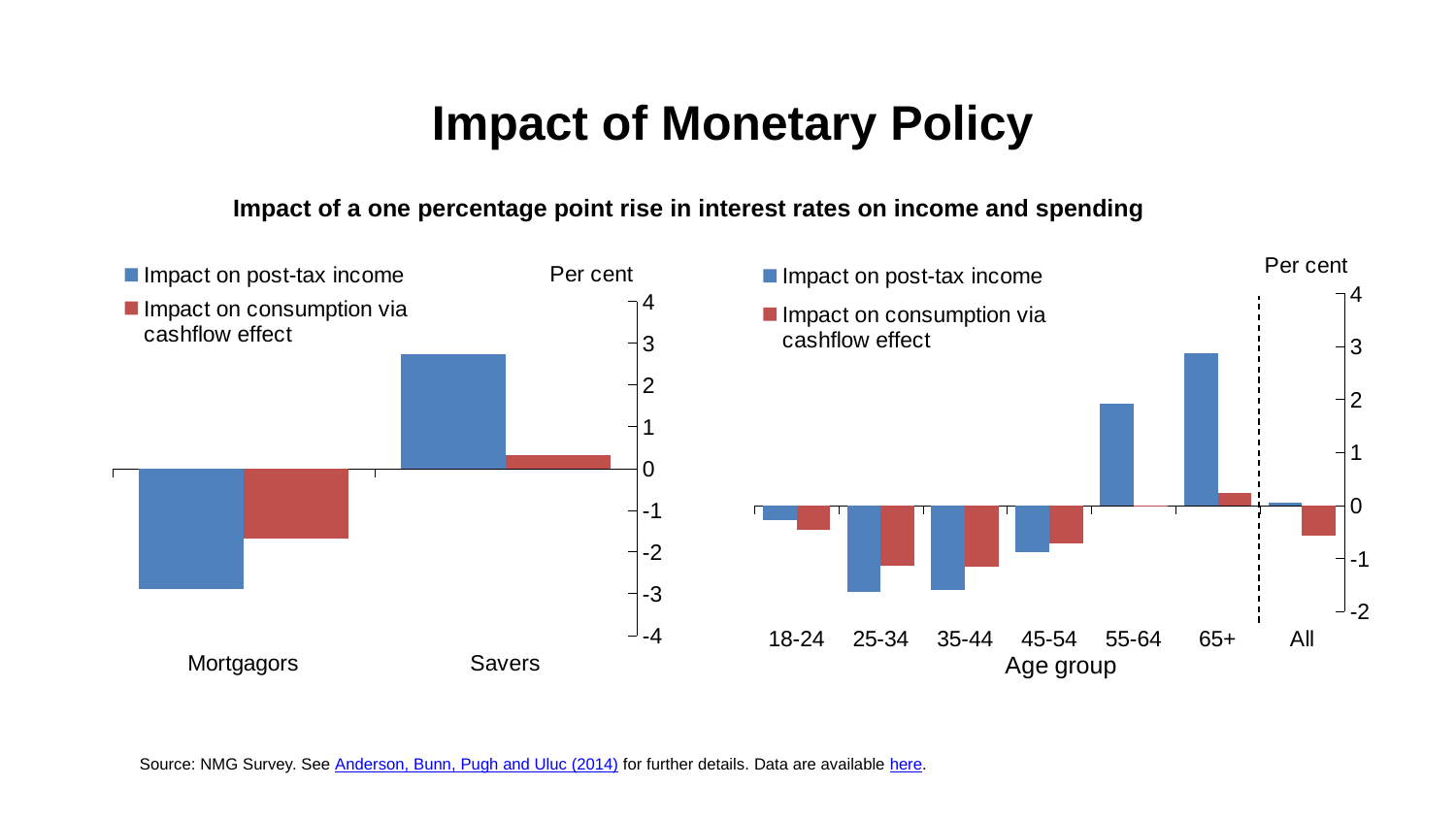
On the left chart (Mortgagors and Savers), how many series does the legend list? 2 On the right chart (by age group), is the impact on post-tax income for 65+ greater or less than 2? greater On the right chart (by age group), how many age groups are shown on the x axis, excluding 'All'? 6 On the left chart (Mortgagors and Savers), which category has the higher impact on post-tax income? Savers On the right chart (by age group), which age group has the highest impact on post-tax income? 65+ On the left chart (Mortgagors and Savers), what kind of chart is shown? bar chart On the left chart (Mortgagors and Savers), is the impact on post-tax income for Savers greater or less than 2? greater On the left chart (Mortgagors and Savers), is the impact on consumption via cashflow effect for Mortgagors greater or less than -1? less On the right chart (by age group), what is the title of the x axis? Age group